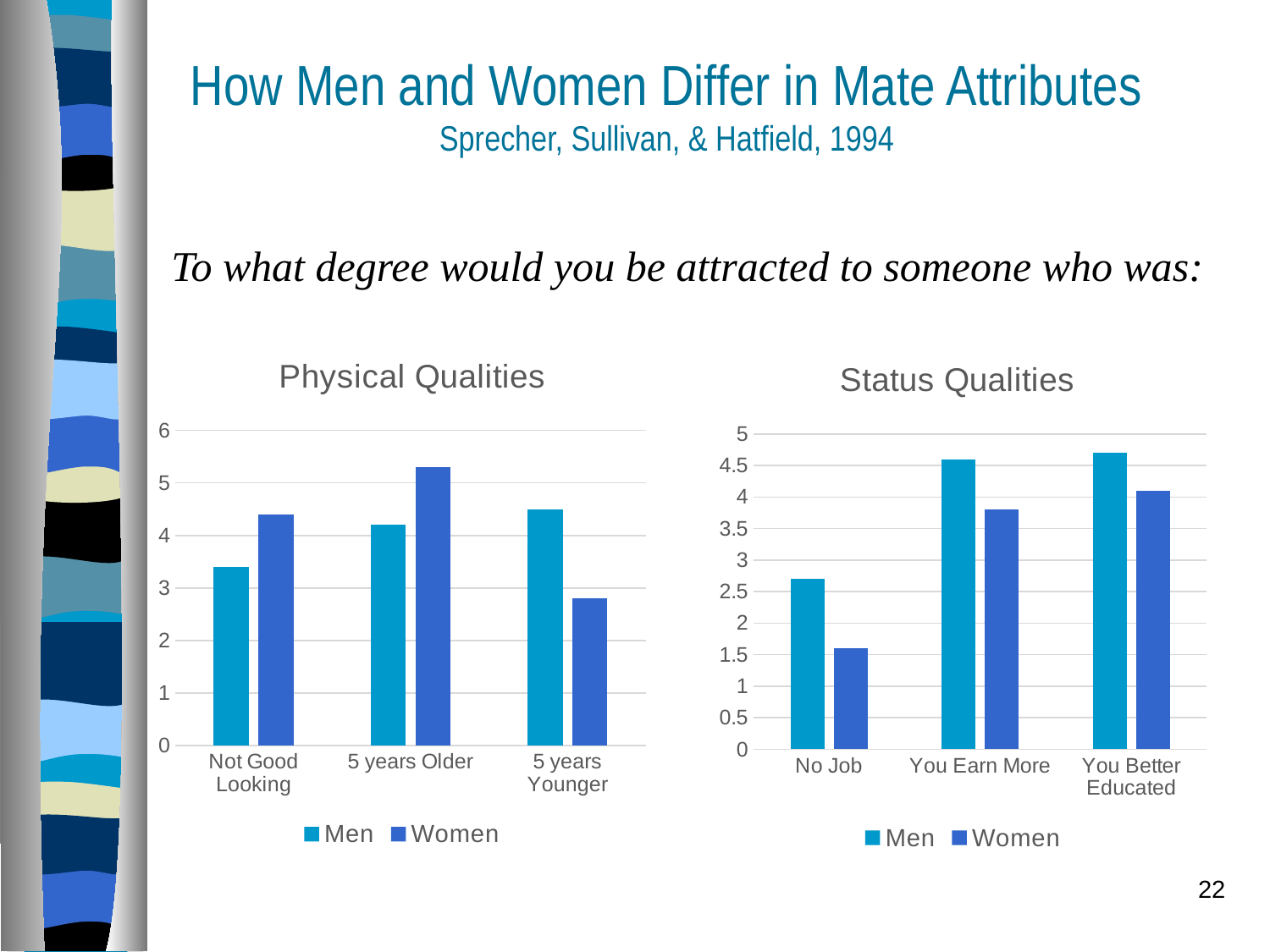
In the Physical Qualities chart, is the Women value for 5 years Older greater or less than 5? greater In the Physical Qualities chart, which category has the highest Women value? 5 years Older How many categories are shown on the x axis of the Physical Qualities chart? 3 In the Status Qualities chart, is the Women value for No Job greater or less than 2? less In the Physical Qualities chart, is the Women value for 5 years Younger greater or less than 4? less In the Status Qualities chart, which category has the lowest Men value? No Job How many series does the legend of the Status Qualities chart list? 2 What kind of chart is the Physical Qualities chart? bar chart In the Physical Qualities chart, which is larger for 5 years Younger, Men or Women? Men